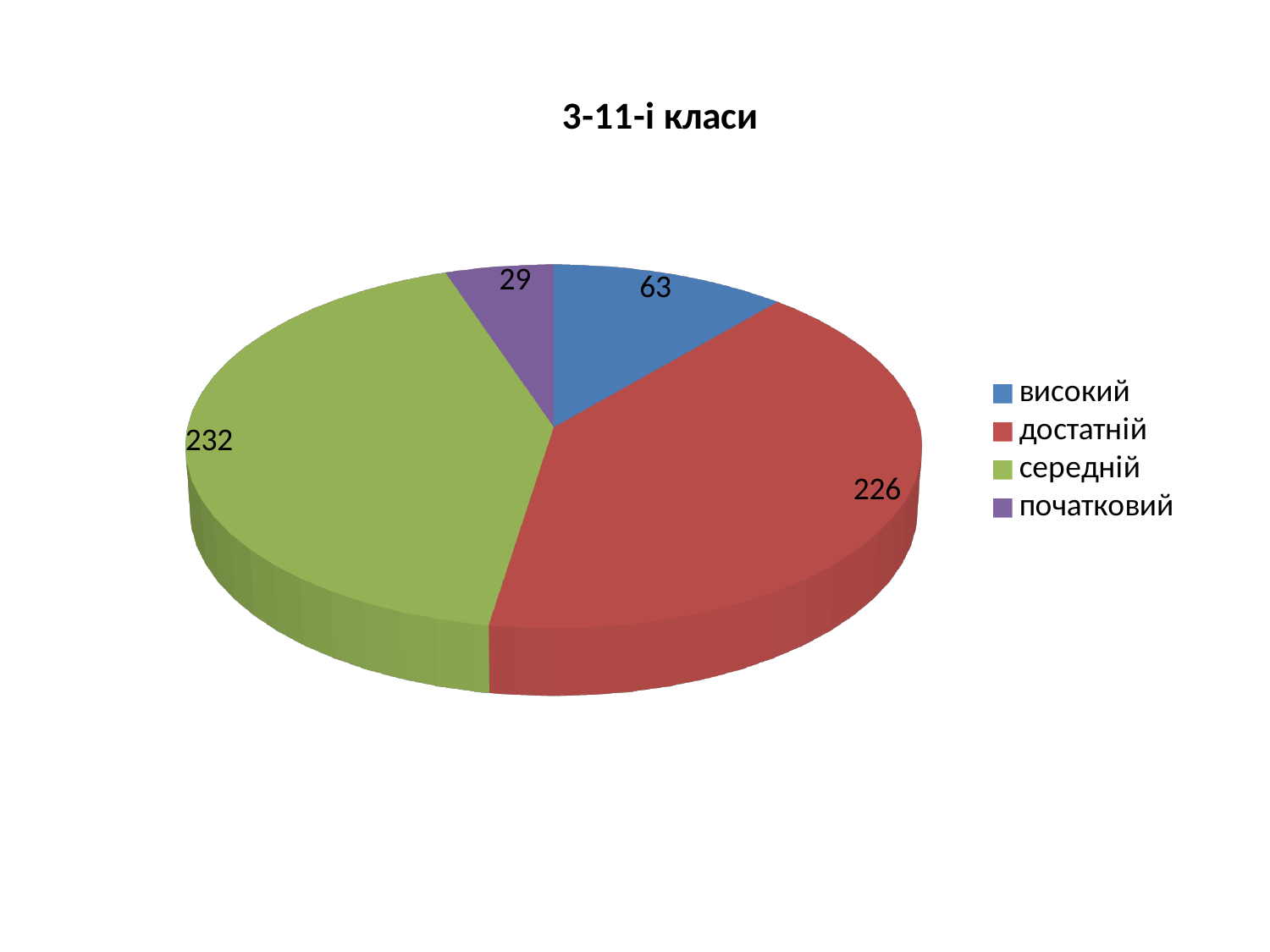
What is the value for початковий? 29 What is the value for середній? 232 What is the value for високий? 63 Which is larger, the value for високий or the value for початковий? високий What is the value for достатній? 226 How many entries does the legend list? 4 How many slices does the pie chart have? 4 What is the title of the chart? 3-11-і класи Which category has the largest value? середній Which category has the smallest value? початковий What is the difference between the values for середній and достатній? 6 What kind of chart is shown on the slide? pie chart